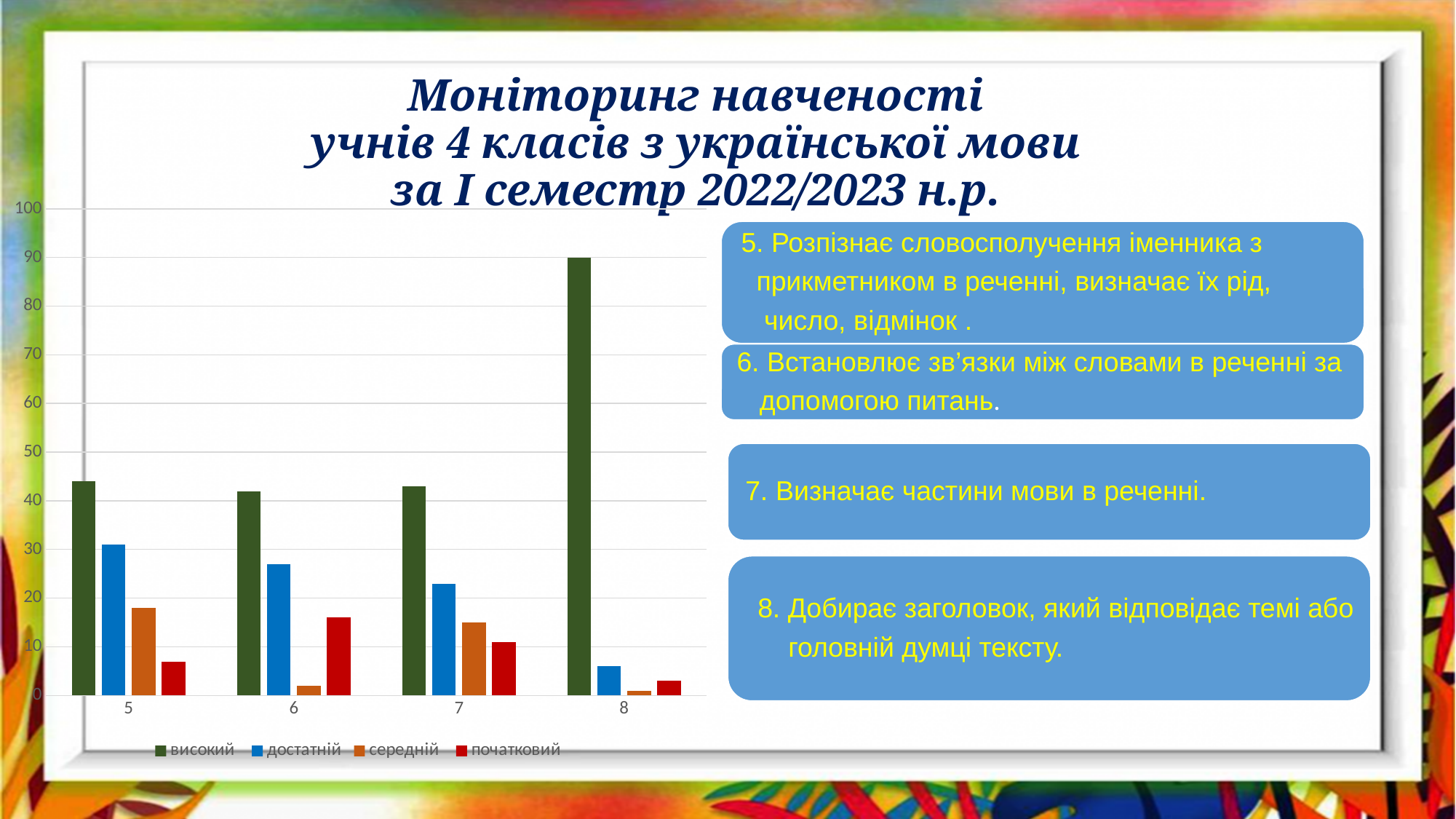
Which category has the lowest value for the series початковий? 8 Is the value for високий in category 8 greater or less than 80? greater How many categories are shown on the x axis of the chart? 4 What colour represents the series високий in the chart? dark green How many series does the chart legend list? 4 Which series has the highest value in category 5? високий Is the value for середній in category 6 greater or less than 10? less Which category has the highest value for the series високий? 8 Which is larger: the value for початковий in category 6 or in category 7? 6 Which is larger: the value for достатній in category 5 or in category 6? 5 What kind of chart is shown on the slide? bar chart Is the value for достатній in category 5 greater or less than 20? greater